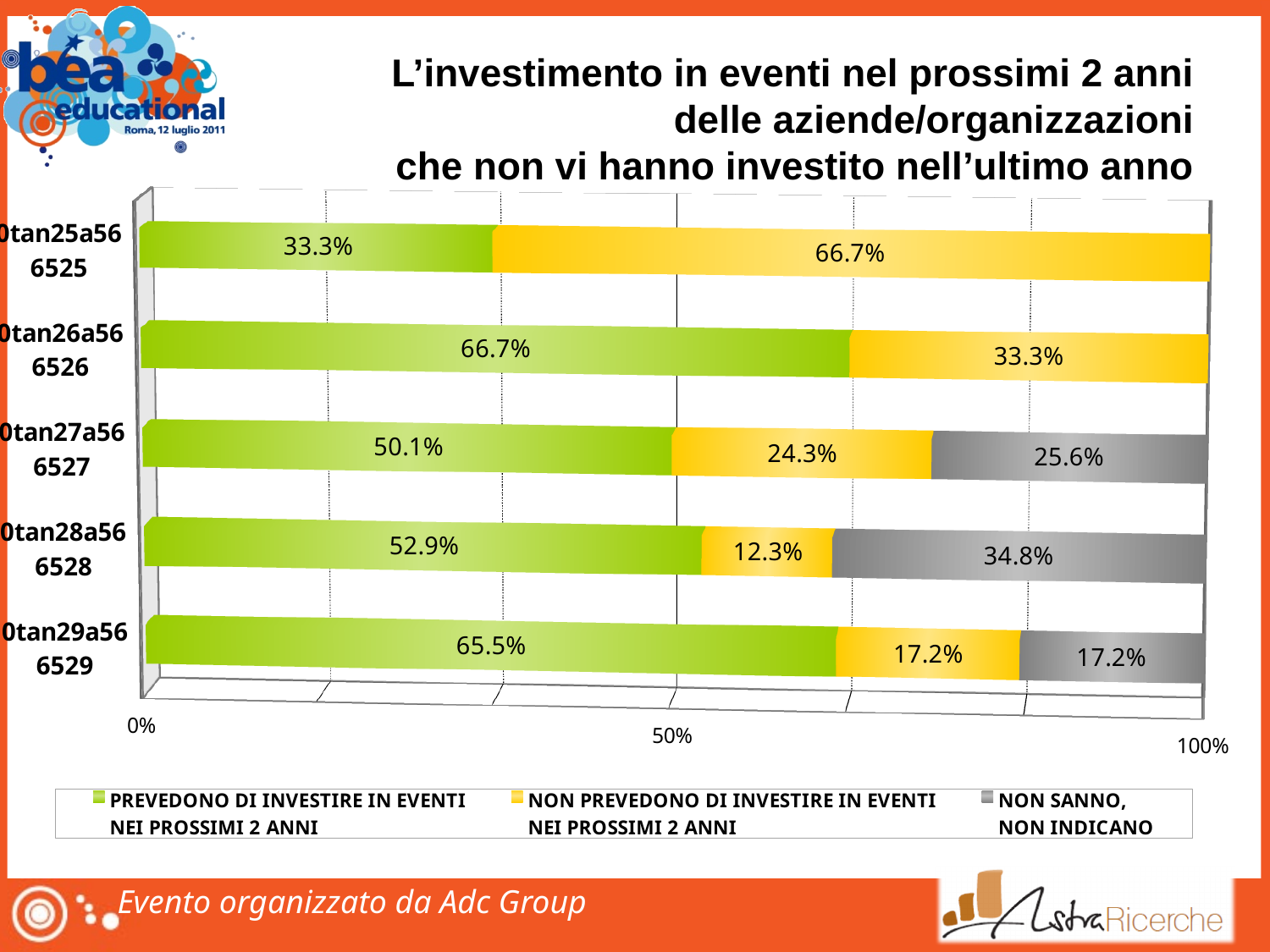
What kind of chart is shown on the slide? Bar chart (stacked horizontal bars) How many series does the legend list? 3 What is the value of the green 'PREVEDONO DI INVESTIRE IN EVENTI NEI PROSSIMI 2 ANNI' segment for the bar labelled 6527 (third from the top)? 50.1% For the bar labelled 6527, which is larger: the yellow 'NON PREVEDONO' segment or the grey 'NON SANNO, NON INDICANO' segment? The grey 'NON SANNO, NON INDICANO' segment (25.6% vs 24.3%) Is the green 'PREVEDONO' value for the bottom bar (6529) greater or less than 50%? greater What colour represents the 'NON SANNO, NON INDICANO' series in the legend? Grey For the top bar (6525), what is the difference between the yellow 'NON PREVEDONO' value and the green 'PREVEDONO' value? 33.4 percentage points How many bars (categories) are plotted in the chart? 5 Which bar has the highest 'PREVEDONO DI INVESTIRE IN EVENTI NEI PROSSIMI 2 ANNI' value? 6526 (second bar from the top), 66.7% Which bar has the lowest 'NON PREVEDONO DI INVESTIRE IN EVENTI NEI PROSSIMI 2 ANNI' value? 6528 (fourth bar from the top), 12.3% What is the value of the grey 'NON SANNO, NON INDICANO' segment for the bar labelled 6528 (fourth from the top)? 34.8% For the bar labelled 6528, what is the difference between the green 'PREVEDONO' value and the yellow 'NON PREVEDONO' value? 40.6 percentage points